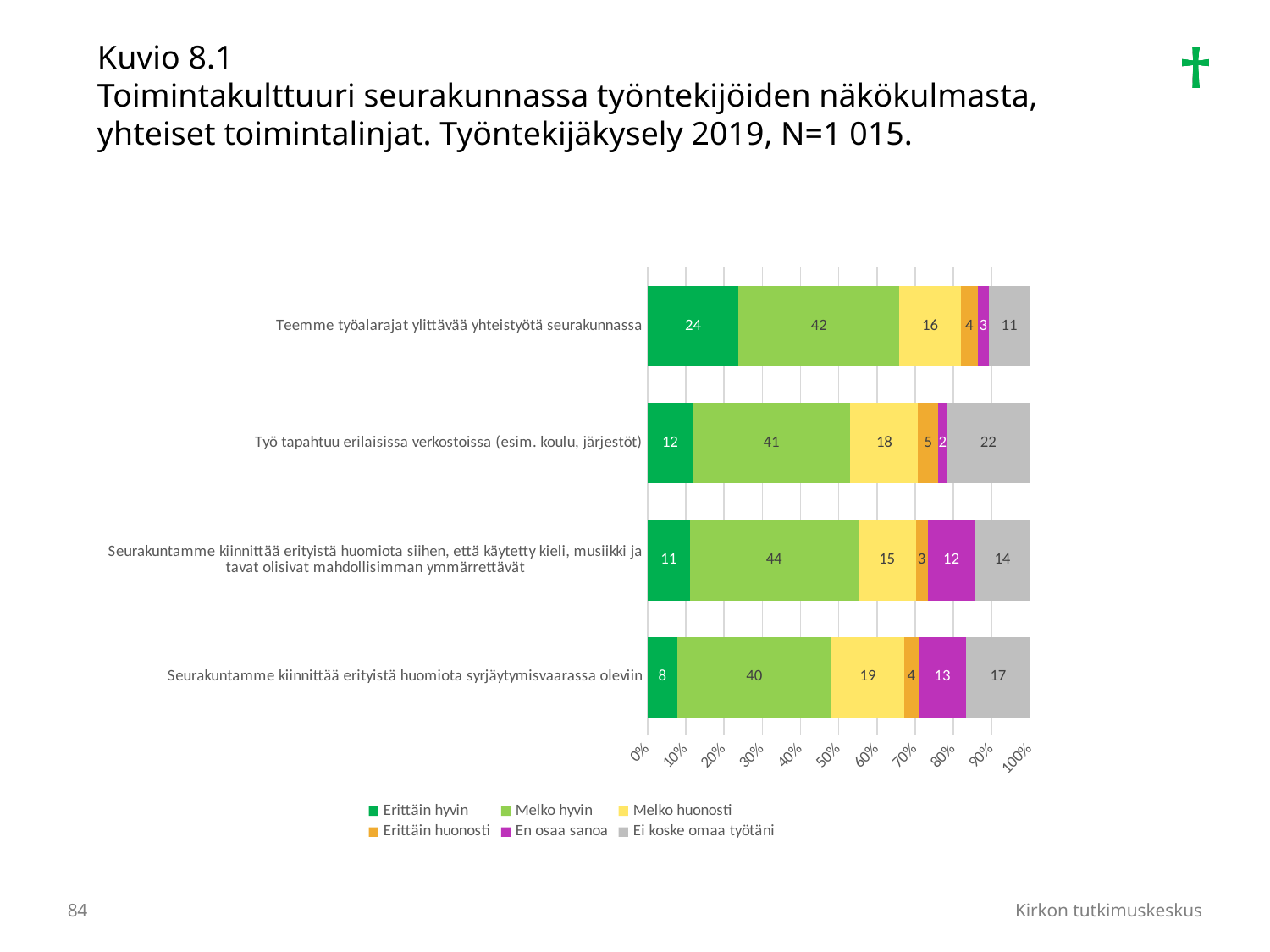
How many statements (categories) are plotted in the chart? 4 Which is larger: the 'Ei koske omaa työtäni' value for 'Työ tapahtuu erilaisissa verkostoissa (esim. koulu, järjestöt)' or for 'Seurakuntamme kiinnittää erityistä huomiota syrjäytymisvaarassa oleviin'? Työ tapahtuu erilaisissa verkostoissa (esim. koulu, järjestöt) What is the 'Melko hyvin' value for 'Seurakuntamme kiinnittää erityistä huomiota siihen, että käytetty kieli, musiikki ja tavat olisivat mahdollisimman ymmärrettävät'? 44 What is the 'Erittäin hyvin' value for 'Teemme työalarajat ylittävää yhteistyötä seurakunnassa'? 24 What is the 'En osaa sanoa' value for 'Seurakuntamme kiinnittää erityistä huomiota syrjäytymisvaarassa oleviin'? 13 Which statement has the lowest 'Erittäin hyvin' value? Seurakuntamme kiinnittää erityistä huomiota syrjäytymisvaarassa oleviin What is the difference between the 'Melko huonosti' values for 'Seurakuntamme kiinnittää erityistä huomiota syrjäytymisvaarassa oleviin' and 'Teemme työalarajat ylittävää yhteistyötä seurakunnassa'? 3 What is the 'Ei koske omaa työtäni' value for 'Työ tapahtuu erilaisissa verkostoissa (esim. koulu, järjestöt)'? 22 Which colour represents 'En osaa sanoa' in the legend? purple Which statement has the highest 'Erittäin hyvin' value? Teemme työalarajat ylittävää yhteistyötä seurakunnassa How many series does the legend list? 6 What type of chart is shown on the slide? stacked bar chart